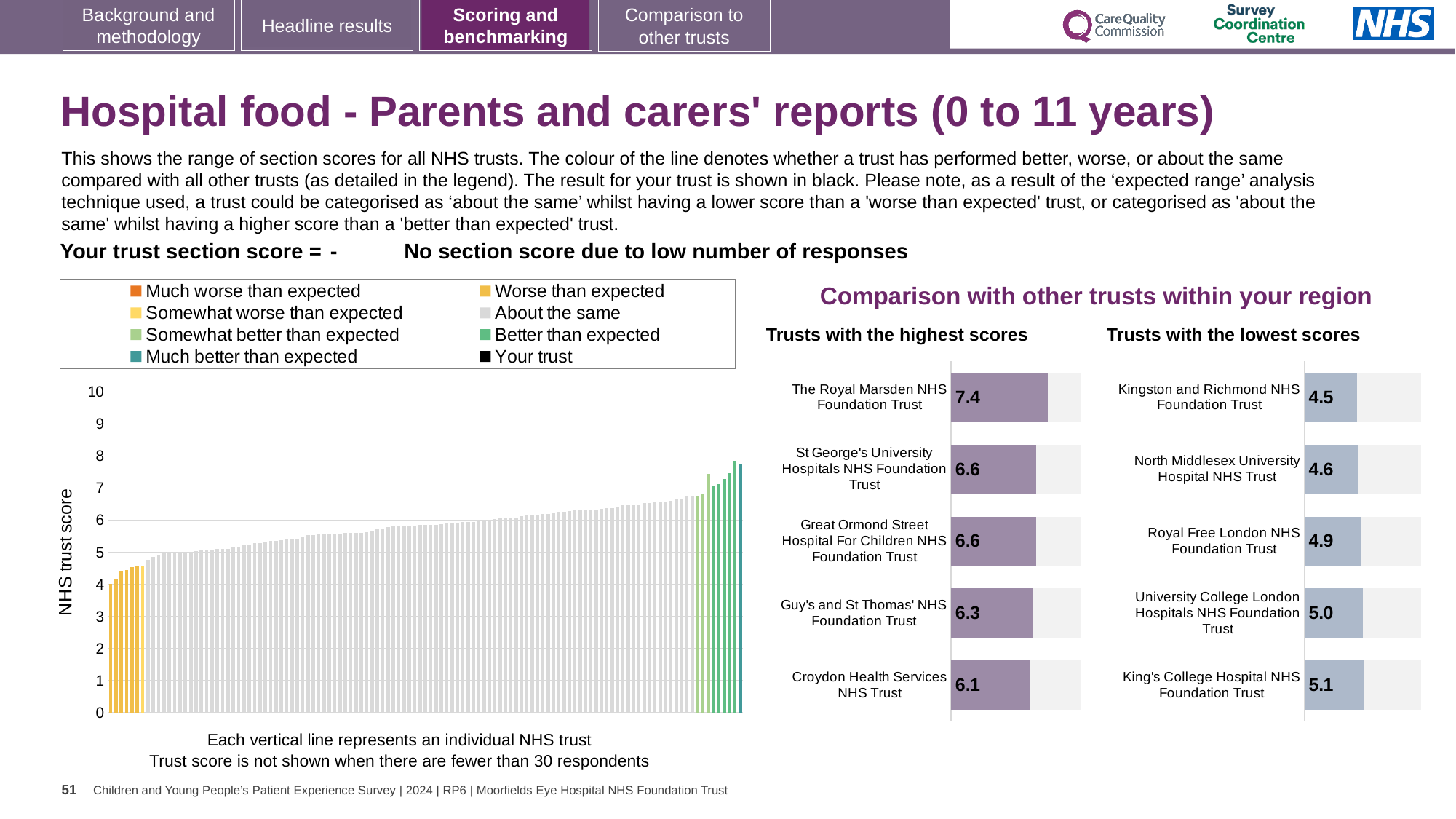
In the 'Trusts with the lowest scores' chart, which trust has the lowest score? Kingston and Richmond NHS Foundation Trust In the 'Trusts with the highest scores' chart, which has the larger score: Guy's and St Thomas' NHS Foundation Trust or Croydon Health Services NHS Trust? Guy's and St Thomas' NHS Foundation Trust In the 'Trusts with the lowest scores' chart, what is the difference between King's College Hospital NHS Foundation Trust and Kingston and Richmond NHS Foundation Trust? 0.6 In the 'NHS trust score' chart on the left, do the bars rise or fall from left to right? Rise In the 'Trusts with the highest scores' chart, what is the difference between The Royal Marsden NHS Foundation Trust and Croydon Health Services NHS Trust? 1.3 In the 'NHS trust score' chart on the left, is the value of the tallest bar greater or less than 7? greater How many trusts are shown in the 'Trusts with the lowest scores' chart? 5 In the 'Trusts with the lowest scores' chart, what is the score for Royal Free London NHS Foundation Trust? 4.9 How many entries does the legend of the 'NHS trust score' chart list? 8 In the 'Trusts with the highest scores' chart, which trust has the highest score? The Royal Marsden NHS Foundation Trust In the 'Trusts with the highest scores' chart, what is the score for The Royal Marsden NHS Foundation Trust? 7.4 What kind of chart is the 'NHS trust score' chart on the left? Bar chart